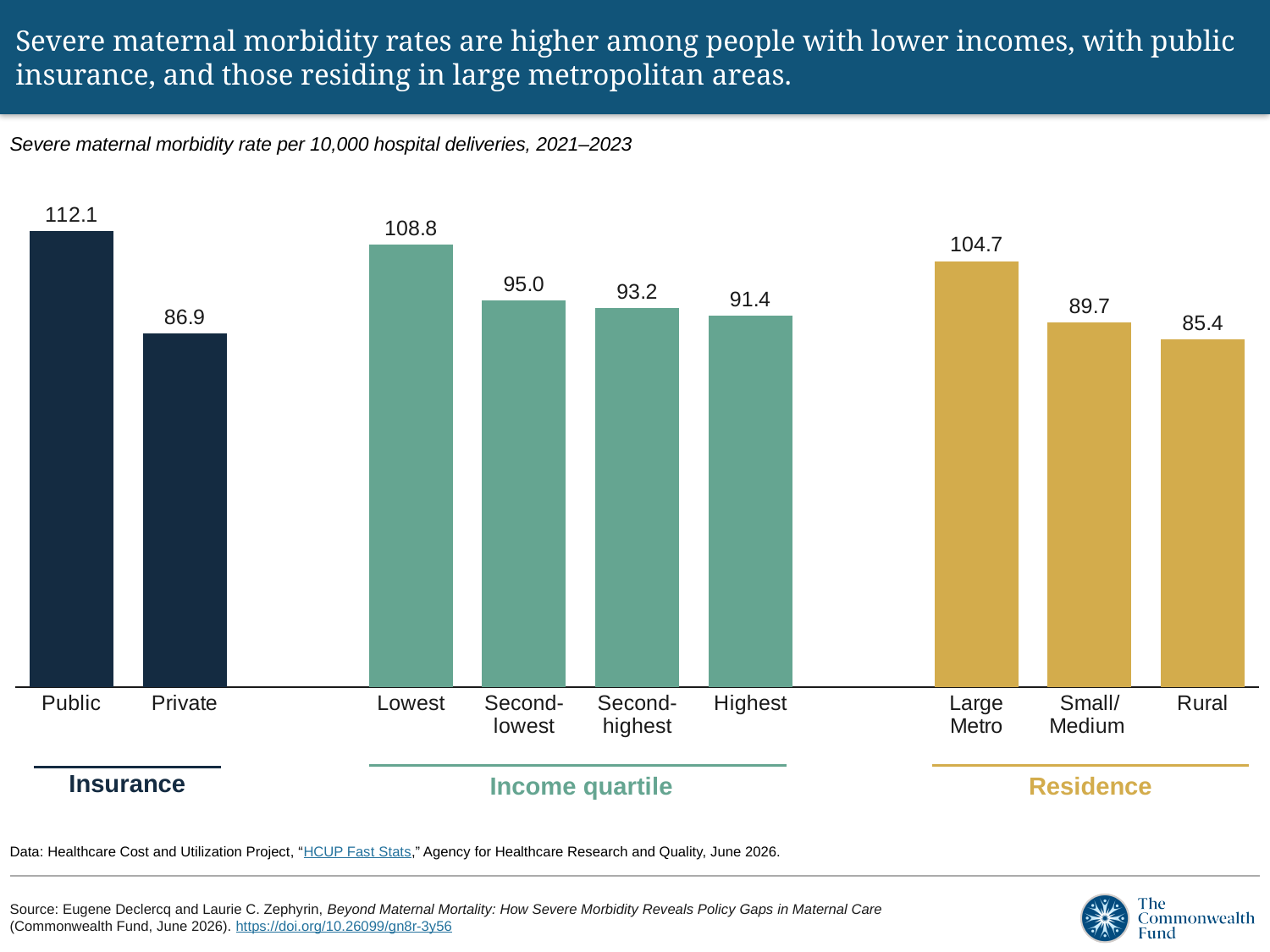
Which category has the highest severe maternal morbidity rate on the chart? Public What is the difference between the severe maternal morbidity rates for Large Metro and Rural residence? 19.3 Which has a higher severe maternal morbidity rate, the Lowest income quartile or Large Metro residence? Lowest income quartile How many bars are plotted on the chart in total? 9 What is the severe maternal morbidity rate for the Second-lowest income quartile? 95.0 What is the severe maternal morbidity rate for Rural residence? 85.4 Do the severe maternal morbidity rates rise or fall from the Lowest to the Highest income quartile? Fall Which income quartile has the lowest severe maternal morbidity rate? Highest What kind of chart is shown on the slide? Bar chart How many categories are shown in the Income quartile group? 4 What is the difference between the severe maternal morbidity rates for Public and Private insurance? 25.2 What is the severe maternal morbidity rate per 10,000 hospital deliveries for Public insurance? 112.1